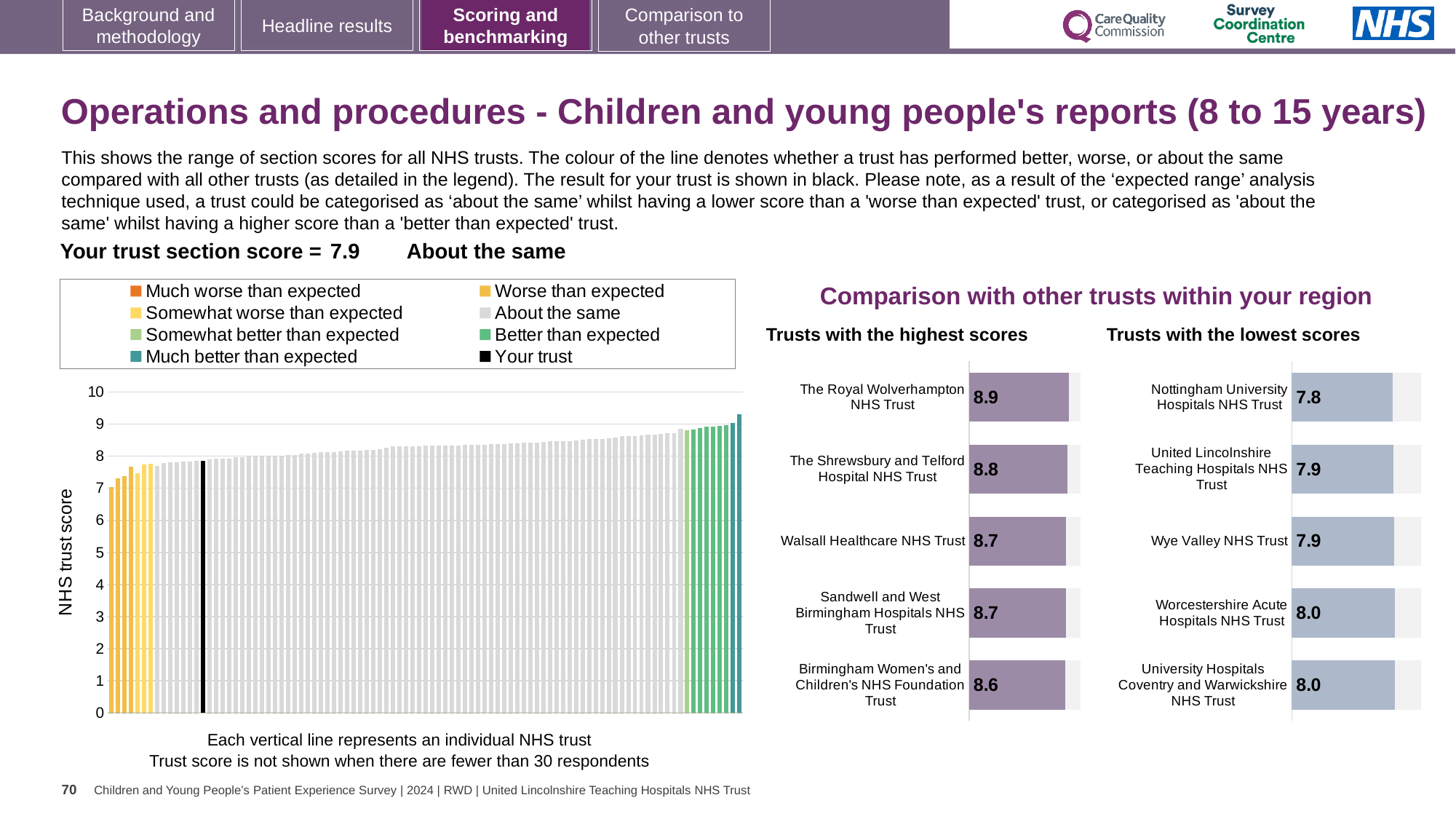
How many trusts are shown in the 'Trusts with the lowest scores' chart? 5 In the large chart on the left, do the NHS trust scores rise or fall from left to right? Rise In the 'Trusts with the highest scores' chart, which trust has the highest score? The Royal Wolverhampton NHS Trust In the 'Trusts with the lowest scores' chart, what is the score for Worcestershire Acute Hospitals NHS Trust? 8.0 In the 'Trusts with the lowest scores' chart, what is the score for Nottingham University Hospitals NHS Trust? 7.8 What kind of chart is the large chart on the left showing NHS trust scores? Bar chart In the 'Trusts with the highest scores' chart, what is the score for Walsall Healthcare NHS Trust? 8.7 In the 'Trusts with the lowest scores' chart, which trust has the lowest score? Nottingham University Hospitals NHS Trust Which has a higher score: The Shrewsbury and Telford Hospital NHS Trust in the highest scores chart or Wye Valley NHS Trust in the lowest scores chart? The Shrewsbury and Telford Hospital NHS Trust In the 'Trusts with the highest scores' chart, what is the score for The Royal Wolverhampton NHS Trust? 8.9 In the 'Trusts with the lowest scores' chart, what is the difference between the scores of University Hospitals Coventry and Warwickshire NHS Trust and Nottingham University Hospitals NHS Trust? 0.2 In the 'Trusts with the highest scores' chart, what is the difference between the scores of The Royal Wolverhampton NHS Trust and Birmingham Women's and Children's NHS Foundation Trust? 0.3